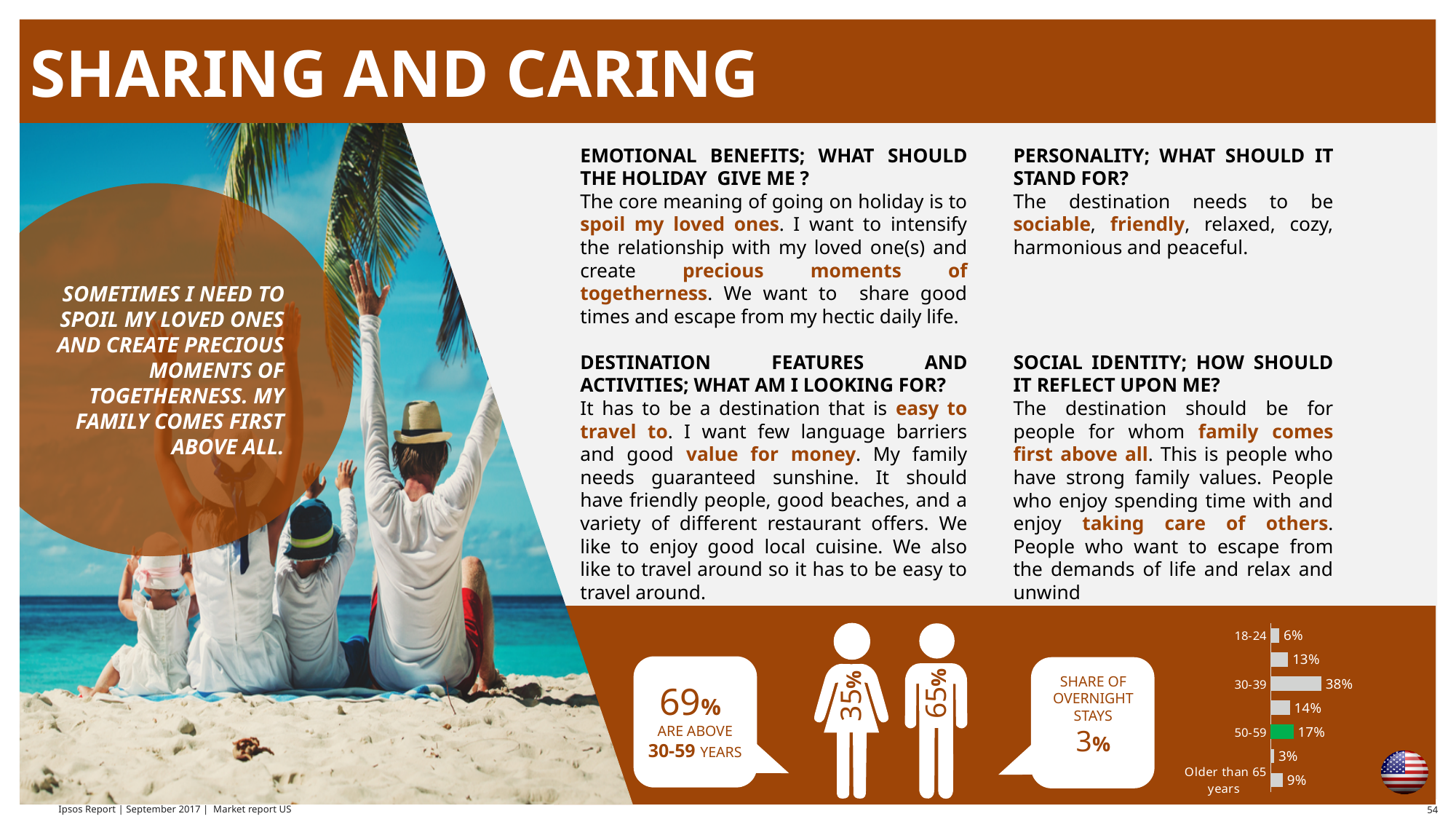
In the age-group bar chart, what is the value for the 'Older than 65 years' group? 9% In the age-group bar chart, which is larger: the value for 18-24 or the value for Older than 65 years? Older than 65 years In the age-group bar chart, what is the difference between the values for the 30-39 group and the 50-59 group? 21% In the age-group bar chart, what is the difference between the values for the 50-59 group and the 18-24 group? 11% What kind of chart is shown at the bottom right of the slide? bar chart How many bars are plotted in the age-group bar chart? 7 In the age-group bar chart, which age group's bar is coloured green rather than grey? 50-59 In the age-group bar chart, what is the value for the 30-39 group? 38% In the age-group bar chart, what is the value for the 18-24 group? 6% In the age-group bar chart, what is the value for the 50-59 group? 17% In the age-group bar chart, what is the smallest value shown on any bar? 3% In the age-group bar chart, which labelled age group has the highest value? 30-39